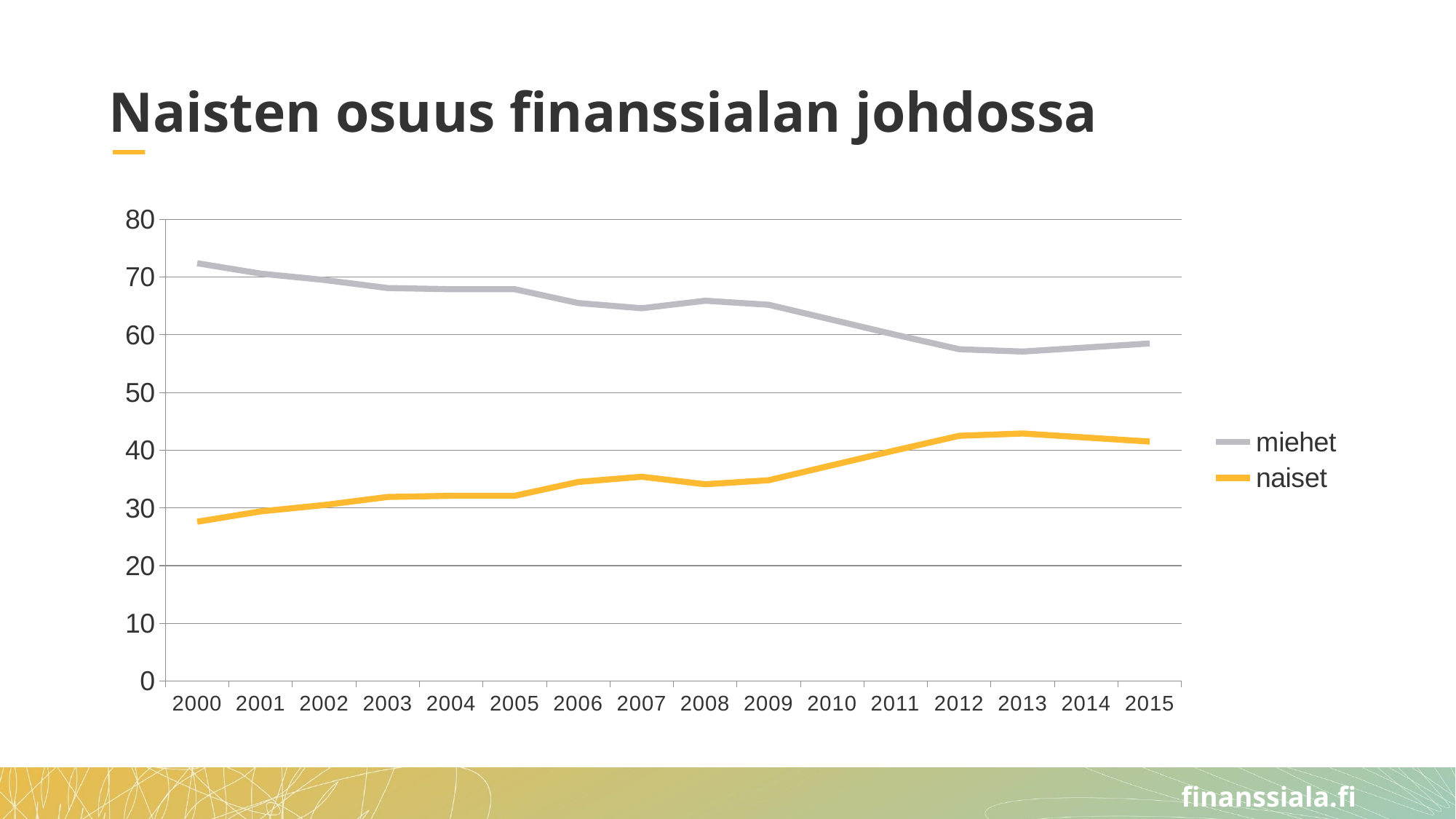
Is the value for naiset in 2000 greater or less than 30? less What is the title of the chart on the slide? Naisten osuus finanssialan johdossa Is the value for miehet in 2013 greater or less than 60? less Which series is drawn in orange? naiset Is the value for naiset in 2013 greater or less than 40? greater Does the miehet line rise or fall from 2000 to 2015? fall What kind of chart is shown on the slide? line chart In 2015, which series has the larger value, miehet or naiset? miehet Does the naiset line rise or fall from 2000 to 2015? rise How many series does the legend list? 2 How many years are shown on the x axis? 16